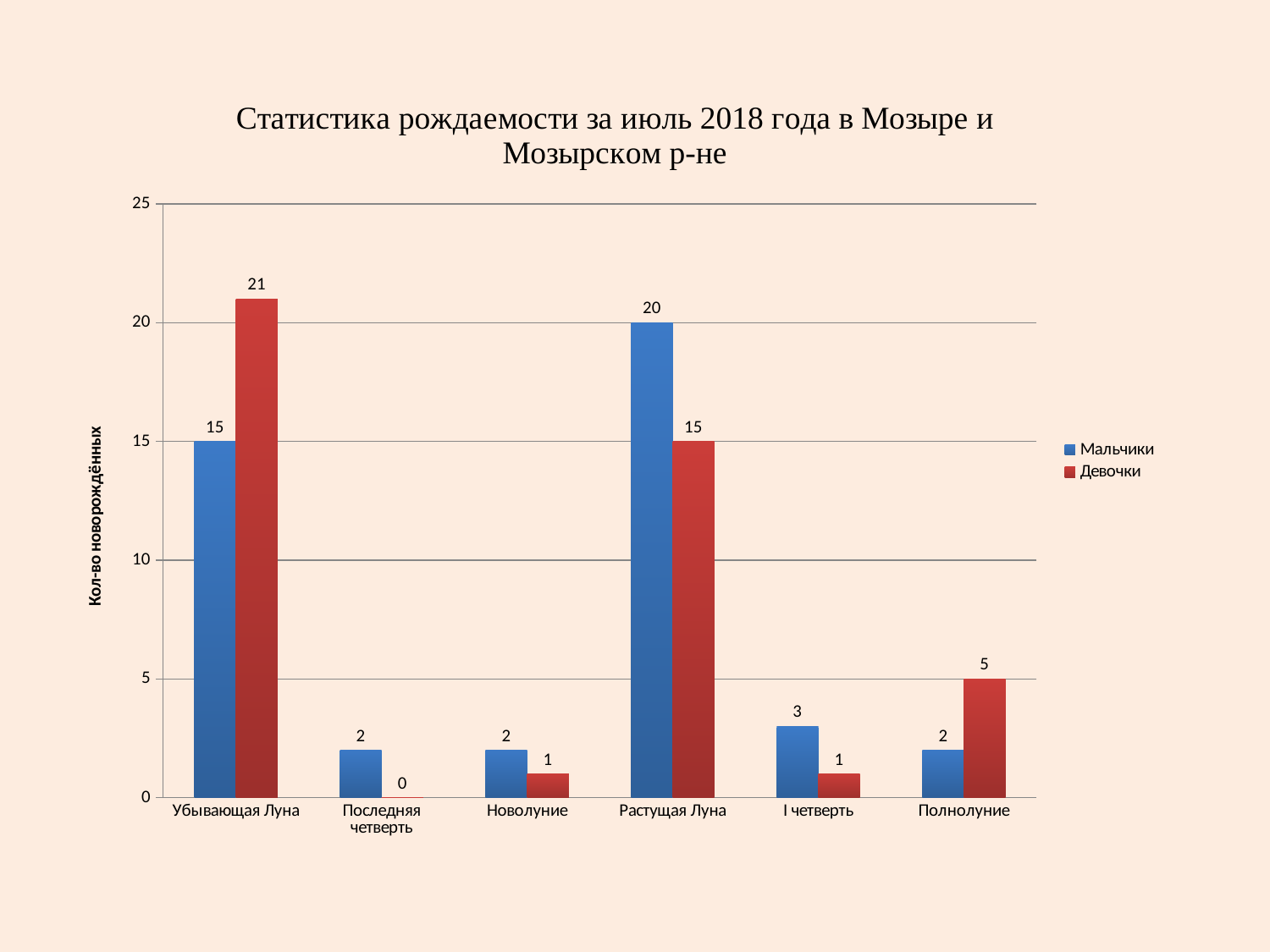
What is the difference between the Мальчики and Девочки values in the Растущая Луна category? 5 Which is larger in the Убывающая Луна category: Мальчики or Девочки? Девочки How many series does the legend list? 2 What is the value for Мальчики in the I четверть category? 3 What is the label of the vertical axis? Кол-во новорождённых What is the value for Девочки in the Убывающая Луна category? 21 What is the value for Девочки in the Полнолуние category? 5 How many categories are shown on the x axis? 6 Which category has the lowest value for Девочки? Последняя четверть What kind of chart is shown on the slide? Bar chart What is the value for Мальчики in the Растущая Луна category? 20 Which category has the highest value for Девочки? Убывающая Луна